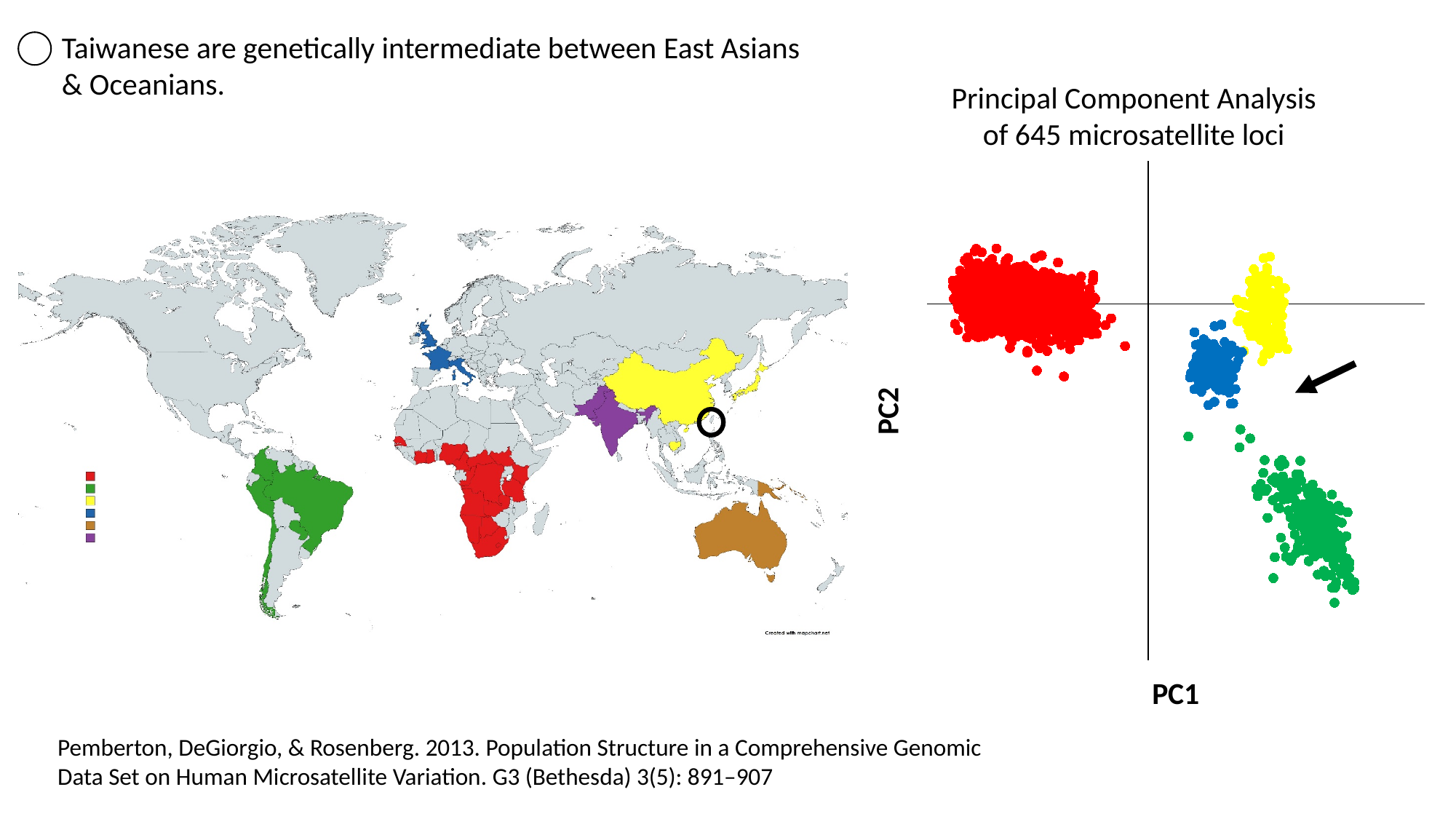
What kind of chart is the Principal Component Analysis plot on the right of the slide? scatter plot What is the title of the chart on the right of the slide? Principal Component Analysis of 645 microsatellite loci In the Principal Component Analysis chart, which cluster is higher on the PC2 axis, the yellow cluster or the green cluster? yellow In the Principal Component Analysis chart, how many differently coloured clusters of points are plotted? 4 In the Principal Component Analysis chart, which coloured cluster lies lowest on the PC2 axis? green In the Principal Component Analysis chart, what is the label of the horizontal axis? PC1 In the Principal Component Analysis chart, which coloured cluster lies furthest to the left on the PC1 axis? red In the Principal Component Analysis chart, which coloured cluster lies furthest to the right on the PC1 axis? green In the Principal Component Analysis chart, is the red cluster to the left or to the right of the vertical axis line? left In the Principal Component Analysis chart, which cluster is further left on the PC1 axis, the red cluster or the blue cluster? red